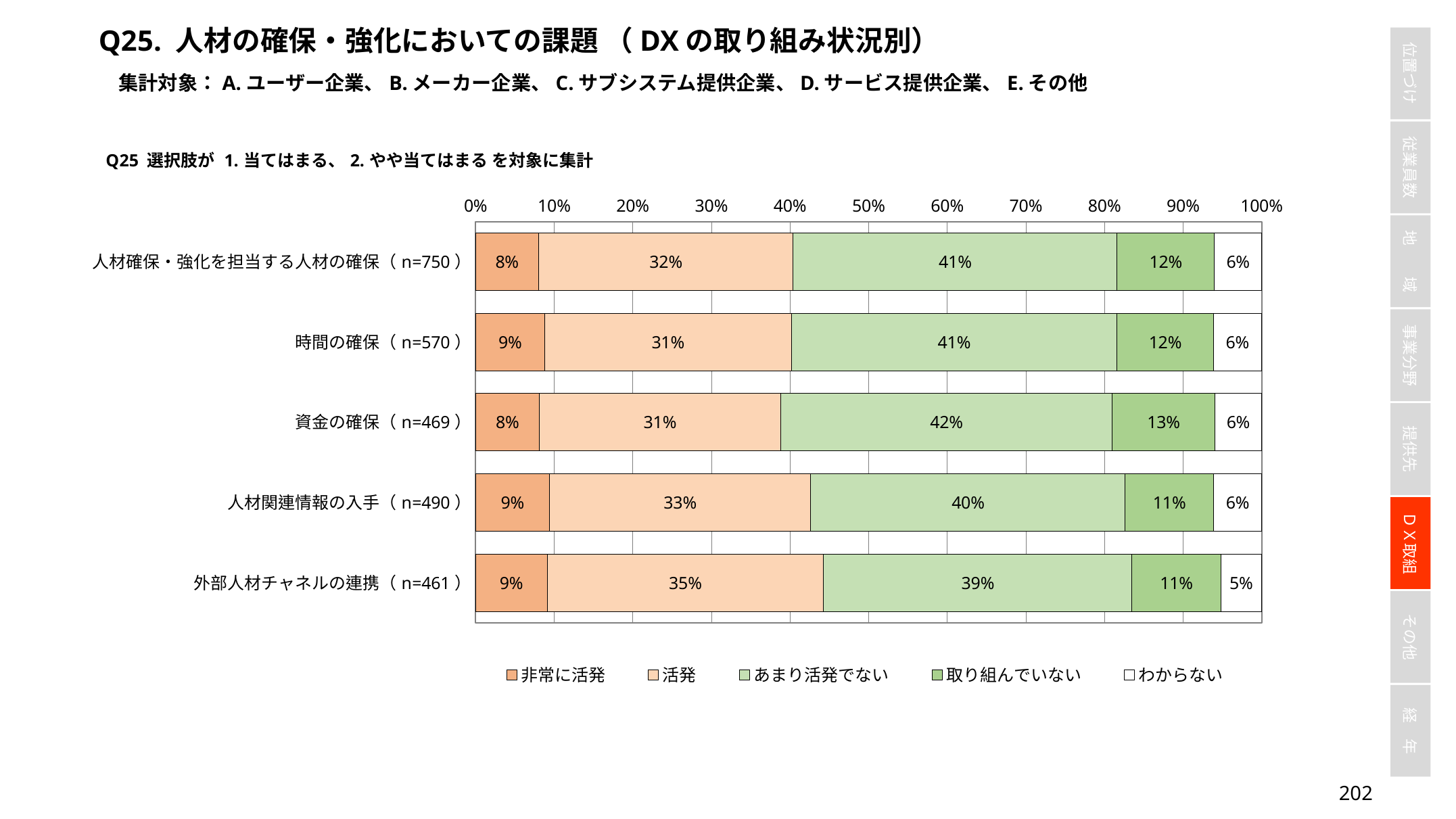
Which category has the lowest value for あまり活発でない? 外部人材チャネルの連携 How many categories are shown on the chart? 5 Which category has the highest value for 活発? 外部人材チャネルの連携 Which category has the highest value for 取り組んでいない? 資金の確保 What percentage of 人材確保・強化を担当する人材の確保 respondents answered 活発? 32% Which is larger: the 取り組んでいない value for 資金の確保 or for 人材関連情報の入手? 資金の確保 How many series does the legend list? 5 What is the value for あまり活発でない in the 資金の確保 bar? 42% What is the value for 非常に活発 in the 時間の確保 bar? 9% What kind of chart is shown on the slide? Stacked bar chart What is the difference between the 活発 values for 外部人材チャネルの連携 and 時間の確保? 4% What is the value for わからない in the 外部人材チャネルの連携 bar? 5%